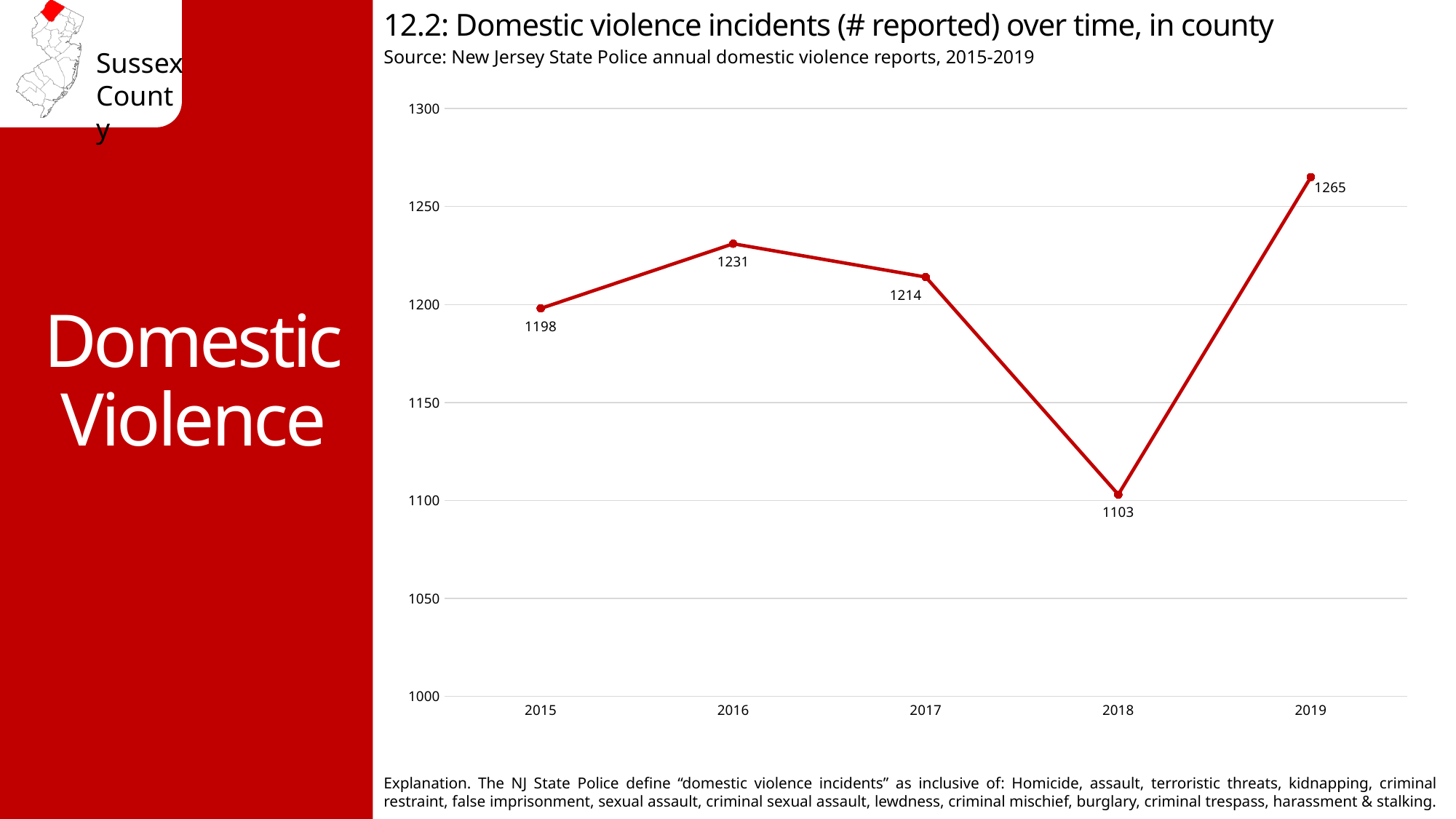
How many years are plotted on the chart? 5 What was the number of reported domestic violence incidents in 2019? 1265 What kind of chart is shown on the slide? line chart What is the difference between the number of incidents in 2019 and 2018? 162 Which year had the highest number of reported domestic violence incidents? 2019 Which year had the lowest number of reported domestic violence incidents? 2018 What is the difference between the number of incidents in 2016 and 2017? 17 Is the value for 2018 greater or less than 1150? less Which year had more reported incidents, 2016 or 2017? 2016 What was the number of reported domestic violence incidents in 2018? 1103 Did the number of reported incidents rise or fall from 2017 to 2018? fall What was the number of reported domestic violence incidents in 2015? 1198